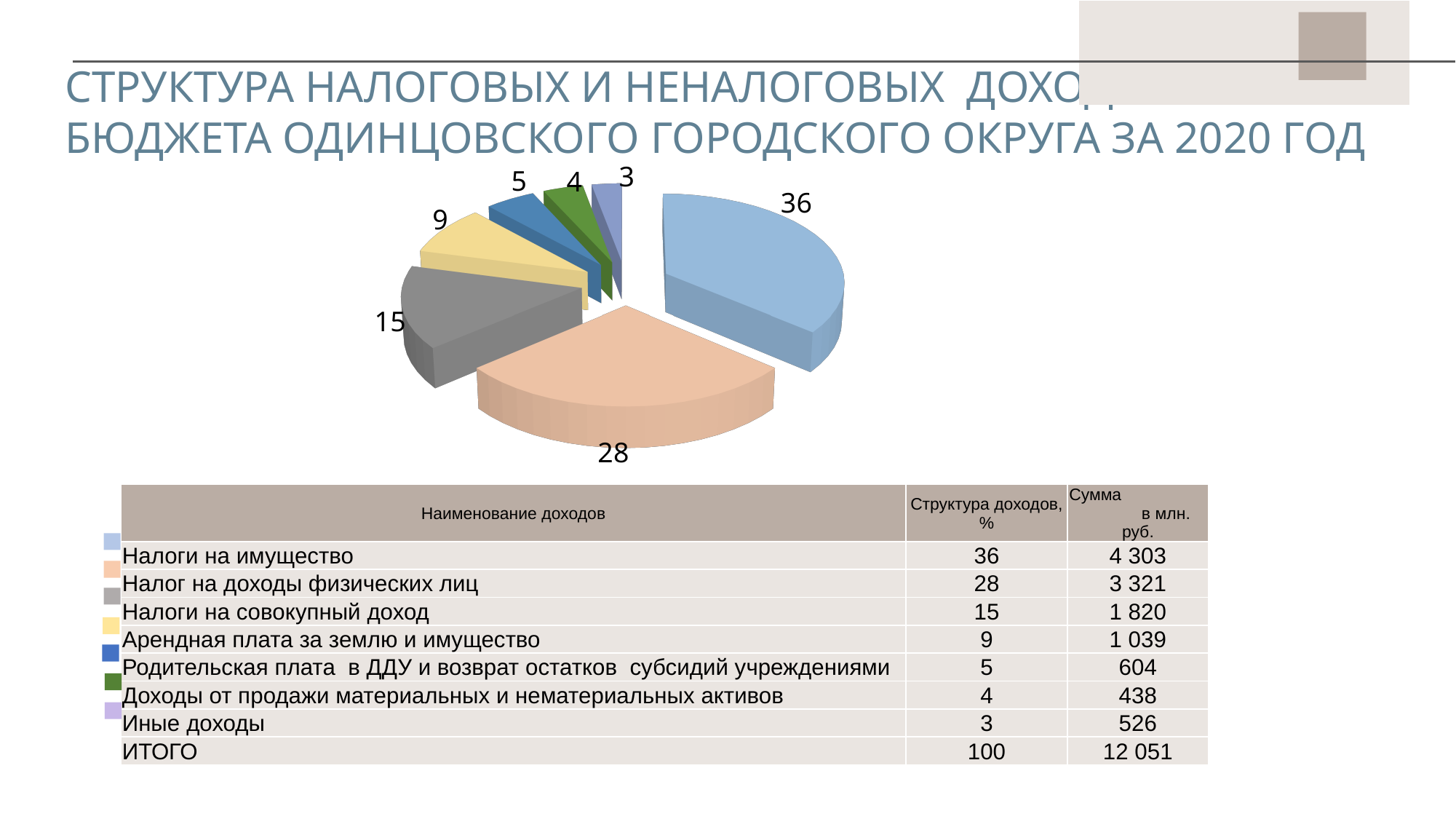
What is the value of the smallest slice of the pie chart? 3 What is the value of the yellow slice in the pie chart? 9 Which category does the largest slice (36) of the pie chart represent, according to the table? Налоги на имущество What is the difference between the two largest slices of the pie chart (36 and 28)? 8 What colour is the slice representing Налог на доходы физических лиц in the pie chart? orange (peach) What is the value of the slice for Налог на доходы физических лиц in the pie chart? 28 How many slices does the pie chart have? 7 Which slice is larger in the pie chart: the one for Арендная плата за землю и имущество or the one for Иные доходы? Арендная плата за землю и имущество What is the value of the grey slice in the pie chart? 15 What kind of chart is shown on the slide? pie chart What is the value of the largest slice of the pie chart? 36 What share of the pie does the slice for Налоги на совокупный доход represent? 15%